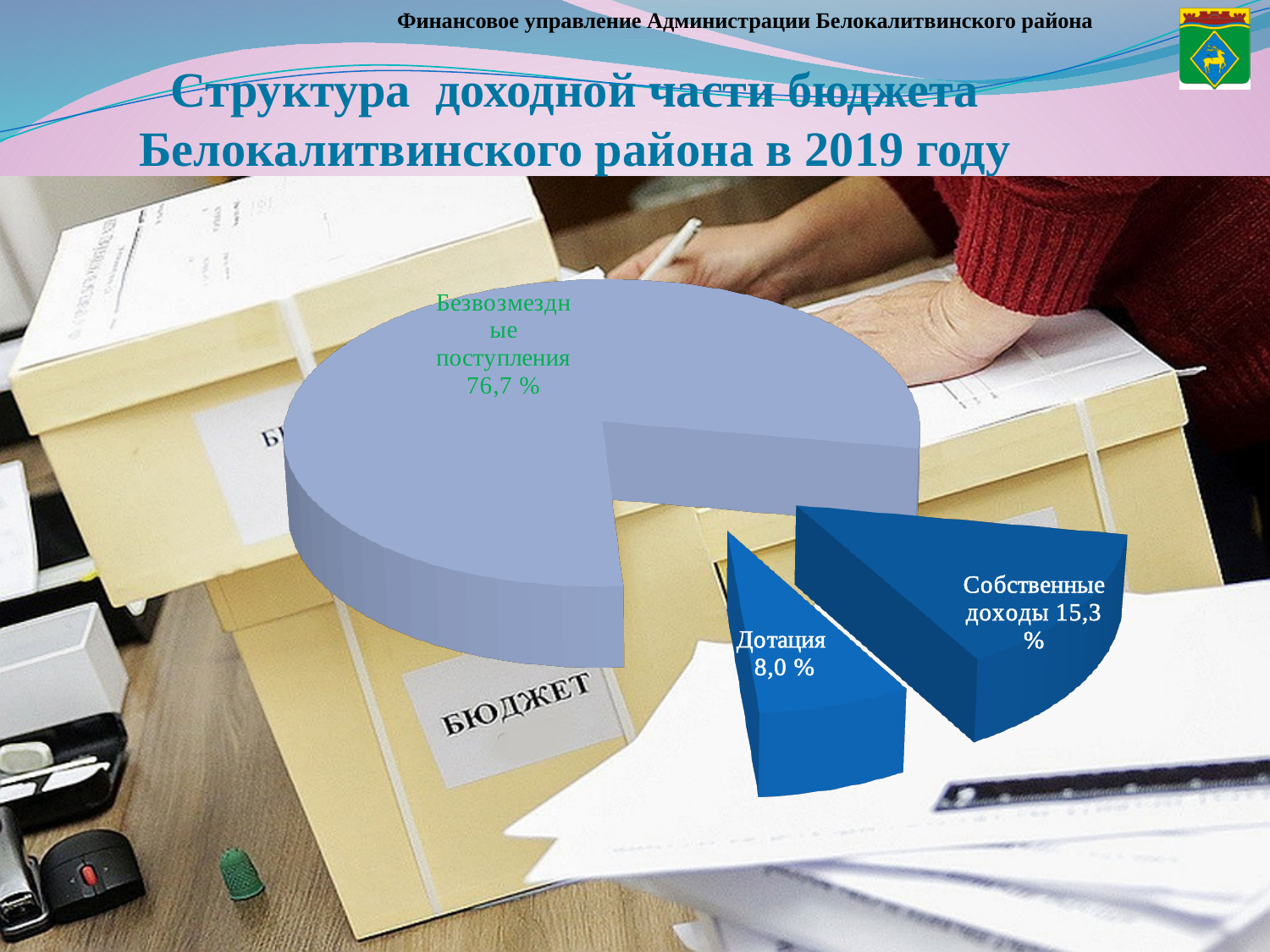
Which year does the chart title say the budget revenue structure refers to? 2019 Which slice of the pie chart is labelled in green text? Безвозмездные поступления What kind of chart is shown on the slide? Pie chart What share of the budget revenue is Дотация? 8,0 % How many slices does the pie chart have? 3 Which is larger, Собственные доходы or Дотация? Собственные доходы Which slice of the pie chart is the smallest? Дотация What share of the budget revenue is Собственные доходы? 15,3 % What share of the budget revenue is Безвозмездные поступления? 76,7 % What is the difference in percentage points between Собственные доходы and Дотация? 7,3 What is the difference in percentage points between Безвозмездные поступления and Собственные доходы? 61,4 Which slice of the pie chart is the largest? Безвозмездные поступления